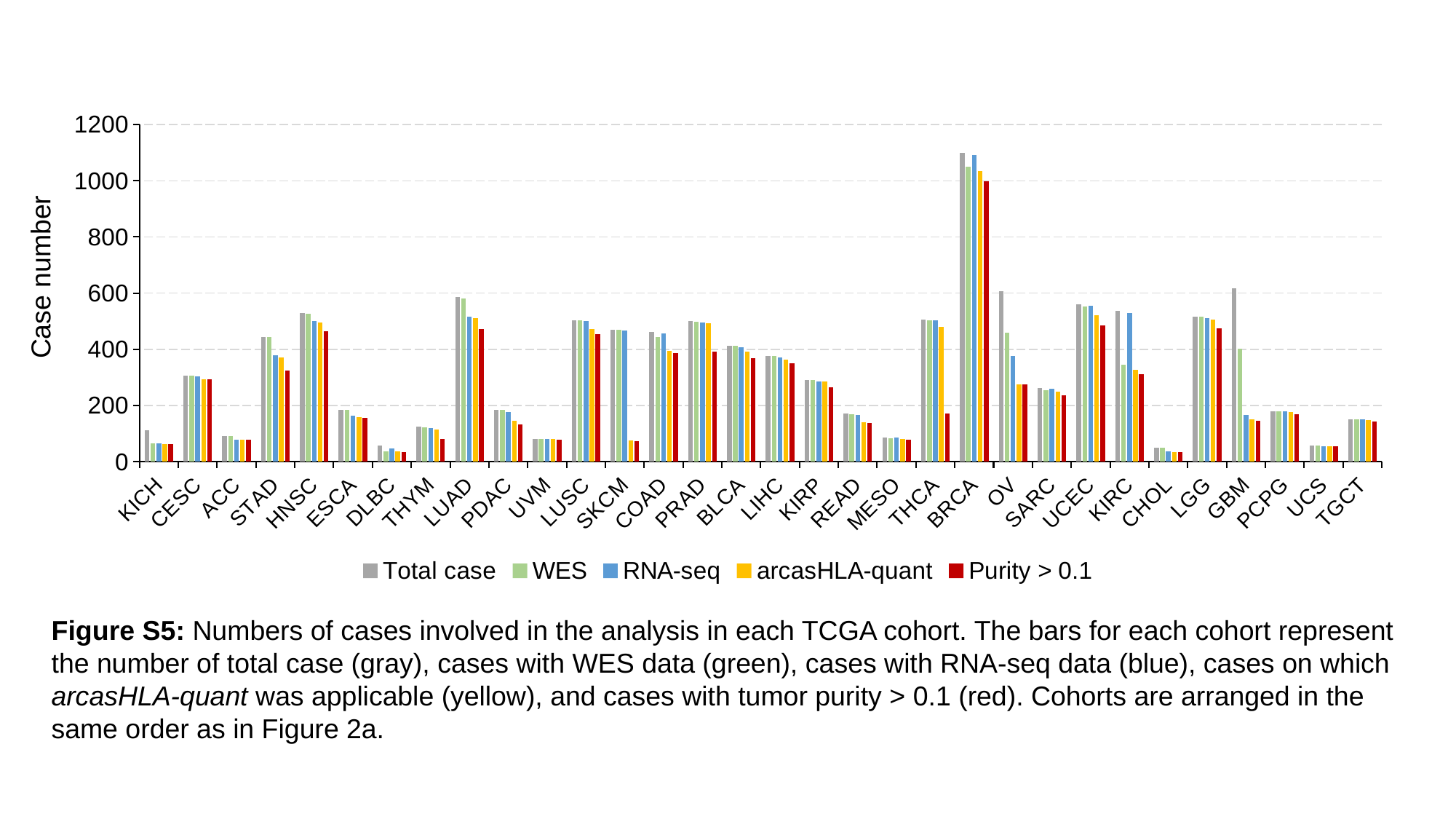
What kind of chart is shown on the slide? bar chart How many series does the legend list? 5 Is the Total case value for LUAD greater or less than 400? greater Which is larger for GBM, the WES value or the RNA-seq value? WES What is the label of the y axis? Case number Is the Total case value for BRCA greater or less than 1000? greater Is the arcasHLA-quant value for SKCM greater or less than 200? less Which cohort has the larger Total case value, BRCA or OV? BRCA Which cohort has the highest Total case value? BRCA How many cohorts are shown along the x axis? 32 Which is larger for KIRC, the RNA-seq value or the WES value? RNA-seq